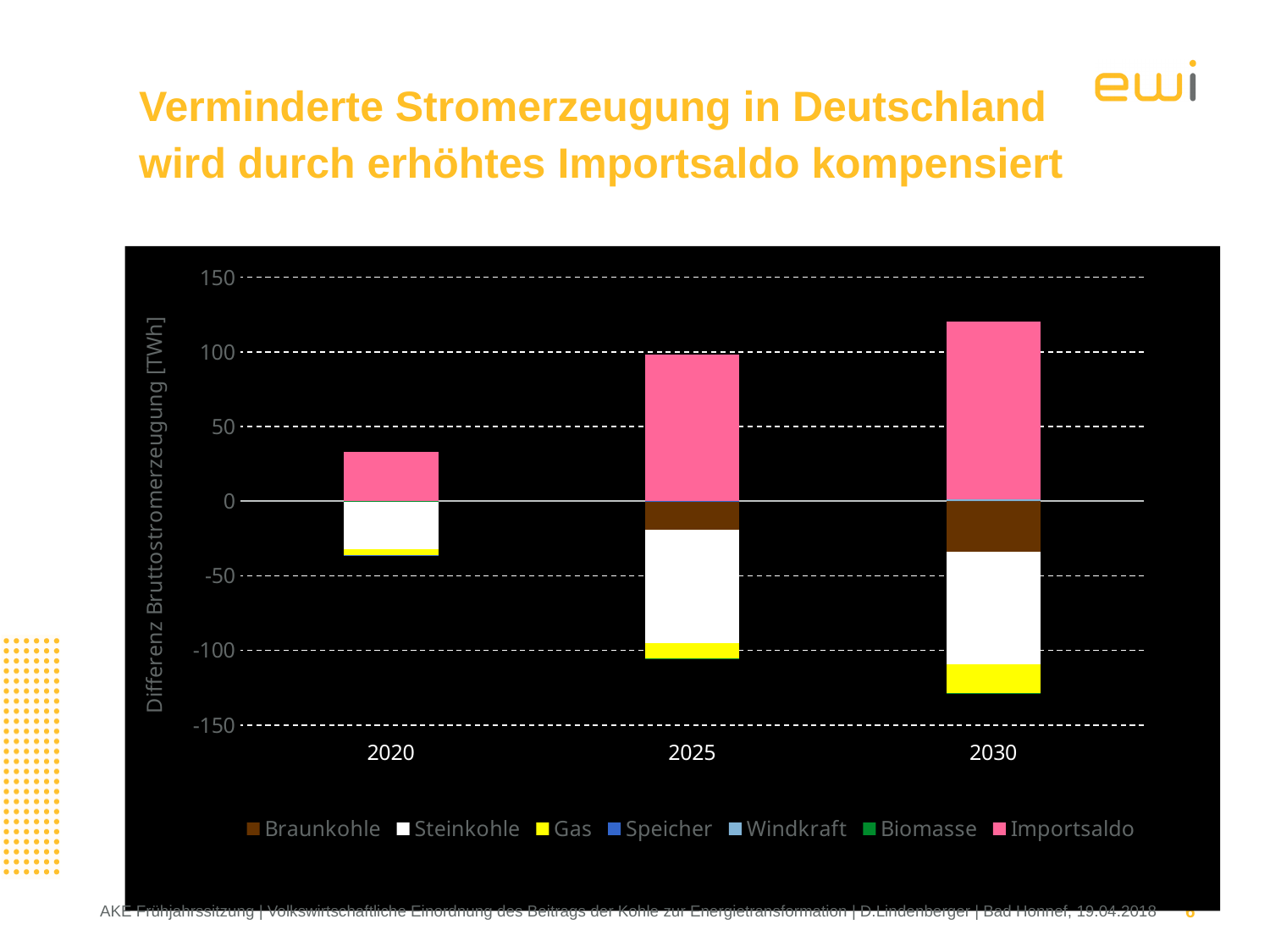
Is the Importsaldo value for 2030 greater or less than 100? greater What kind of chart is shown on the slide? stacked bar chart Does the Importsaldo segment rise or fall from 2020 to 2030? rise Which series is shown in pink in the legend? Importsaldo How many years (categories) are shown on the x axis? 3 Which year has the larger Importsaldo segment, 2020 or 2030? 2030 Is the Importsaldo value for 2020 greater or less than 50? less Is the bottom of the stacked bar for 2030 (the lowest point of the Gas segment) above or below -100? below In which year is the Importsaldo segment the smallest? 2020 In which year is the Importsaldo segment the largest? 2030 How many series does the legend list? 7 What is the label of the vertical axis? Differenz Bruttostromerzeugung [TWh]